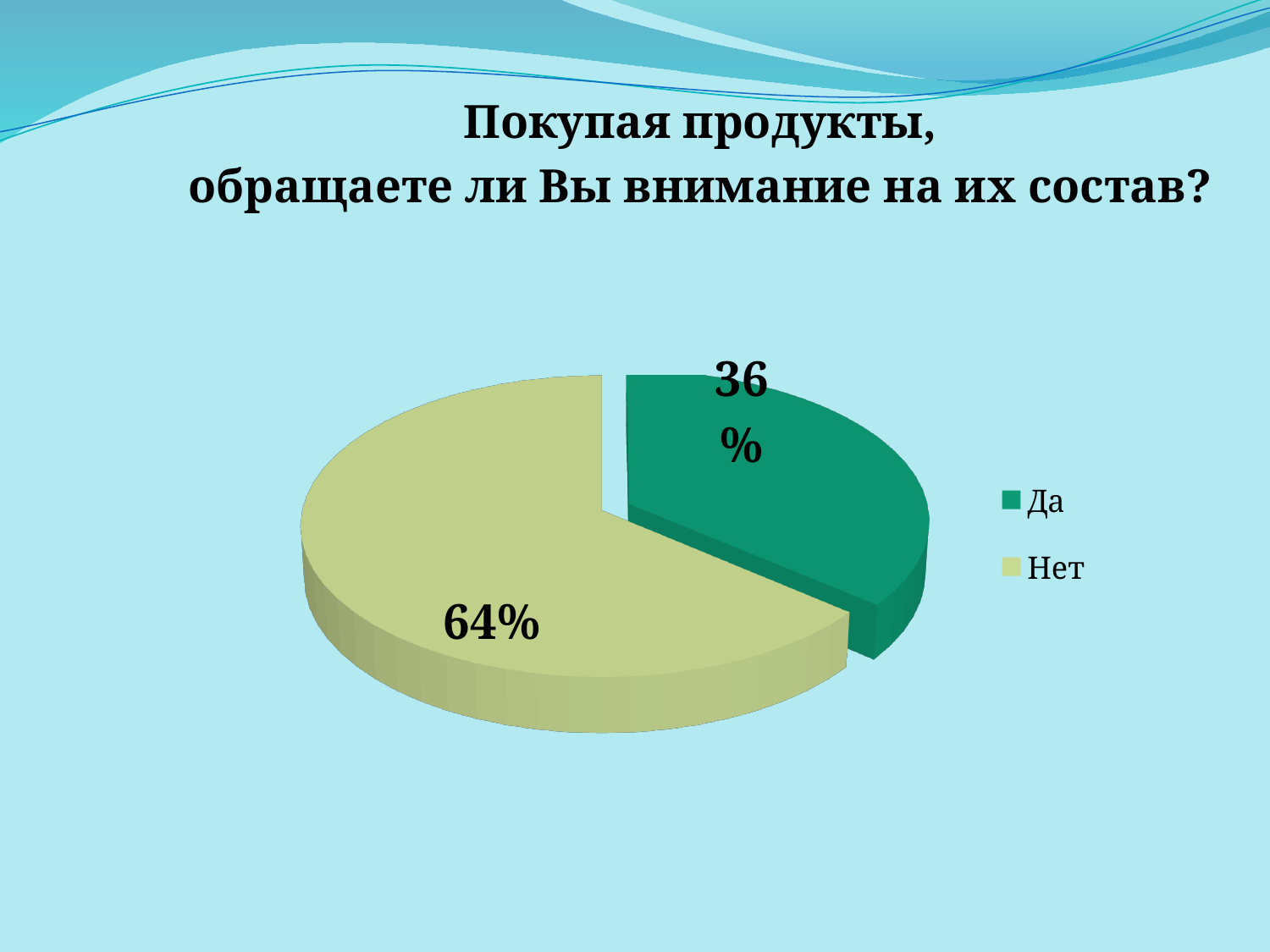
What is the difference in percentage points between the "Нет" and "Да" slices? 28 Which answer has the smallest share of the pie? Да What colour is the "Да" slice? Green How many entries does the legend list? 2 What share of the pie does the "Да" slice represent? 36% How many slices does the pie chart have? 2 What percentage of respondents answered "Нет"? 64% Which answer has the largest share of the pie? Нет What kind of chart is shown on the slide? Pie chart What is the title of the chart? Покупая продукты, обращаете ли Вы внимание на их состав? What percentage of respondents answered "Да"? 36% Which slice is larger, "Да" or "Нет"? Нет